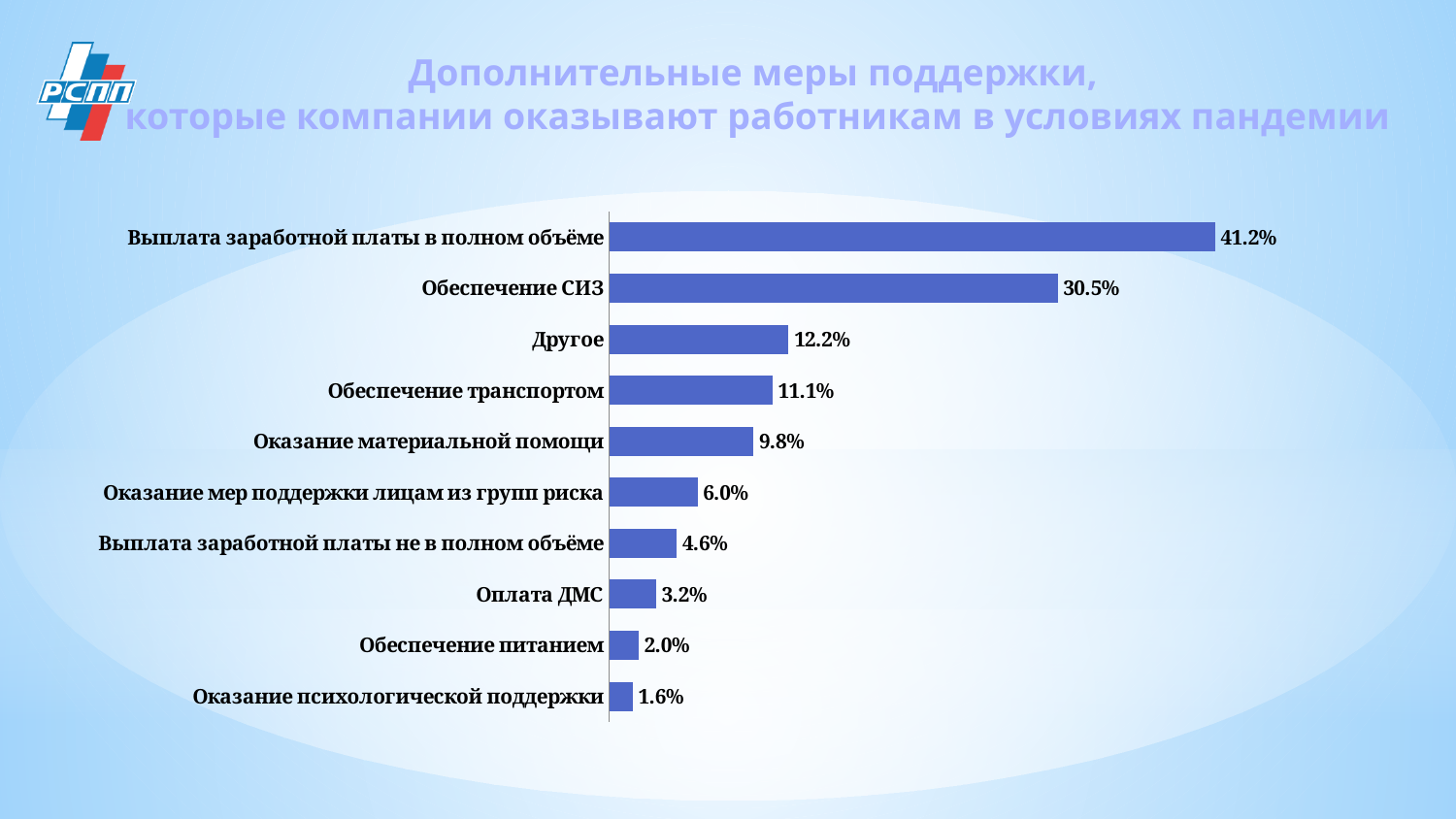
What is the value for "Оказание материальной помощи"? 9.8% Which is larger: the value for "Оказание мер поддержки лицам из групп риска" or the value for "Выплата заработной платы не в полном объёме"? Оказание мер поддержки лицам из групп риска What is the value for "Оплата ДМС"? 3.2% What is the value for "Выплата заработной платы в полном объёме"? 41.2% What is the difference between the values for "Другое" and "Обеспечение транспортом"? 1.1% Which category has the lowest value? Оказание психологической поддержки What is the difference between the values for "Выплата заработной платы в полном объёме" and "Обеспечение СИЗ"? 10.7% What is the value for "Обеспечение питанием"? 2.0% What kind of chart is shown on the slide? Bar chart Which category has the highest value? Выплата заработной платы в полном объёме What is the value for "Обеспечение СИЗ"? 30.5% How many categories are shown in the chart? 10